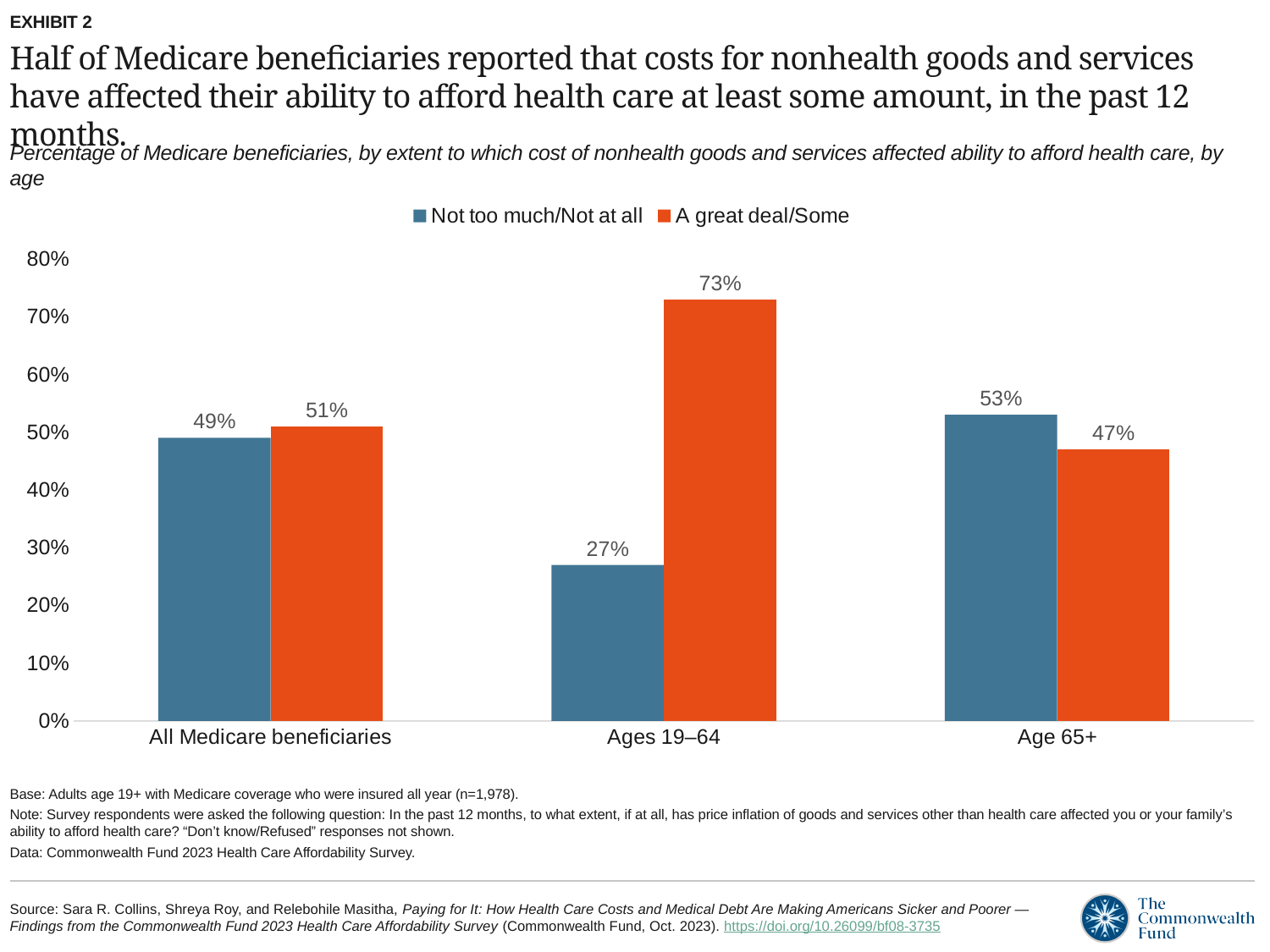
What is the value for 'Not too much/Not at all' among all Medicare beneficiaries? 49% What is the 'A great deal/Some' value for the Age 65+ group? 47% Which colour represents the 'A great deal/Some' series? Orange What is the difference between the 'A great deal/Some' and 'Not too much/Not at all' values for Ages 19–64? 46 percentage points What percentage of Medicare beneficiaries ages 19–64 reported that costs affected their ability to afford health care a great deal/some? 73% Which category has the lowest 'Not too much/Not at all' value? Ages 19–64 Is the 'A great deal/Some' value for Ages 19–64 greater or less than 70%? greater What kind of chart is shown on the slide? Bar chart For the Age 65+ group, which is larger: 'Not too much/Not at all' or 'A great deal/Some'? Not too much/Not at all How many categories are shown on the x axis? 3 How many series does the legend list? 2 Which age category has the highest 'A great deal/Some' value? Ages 19–64